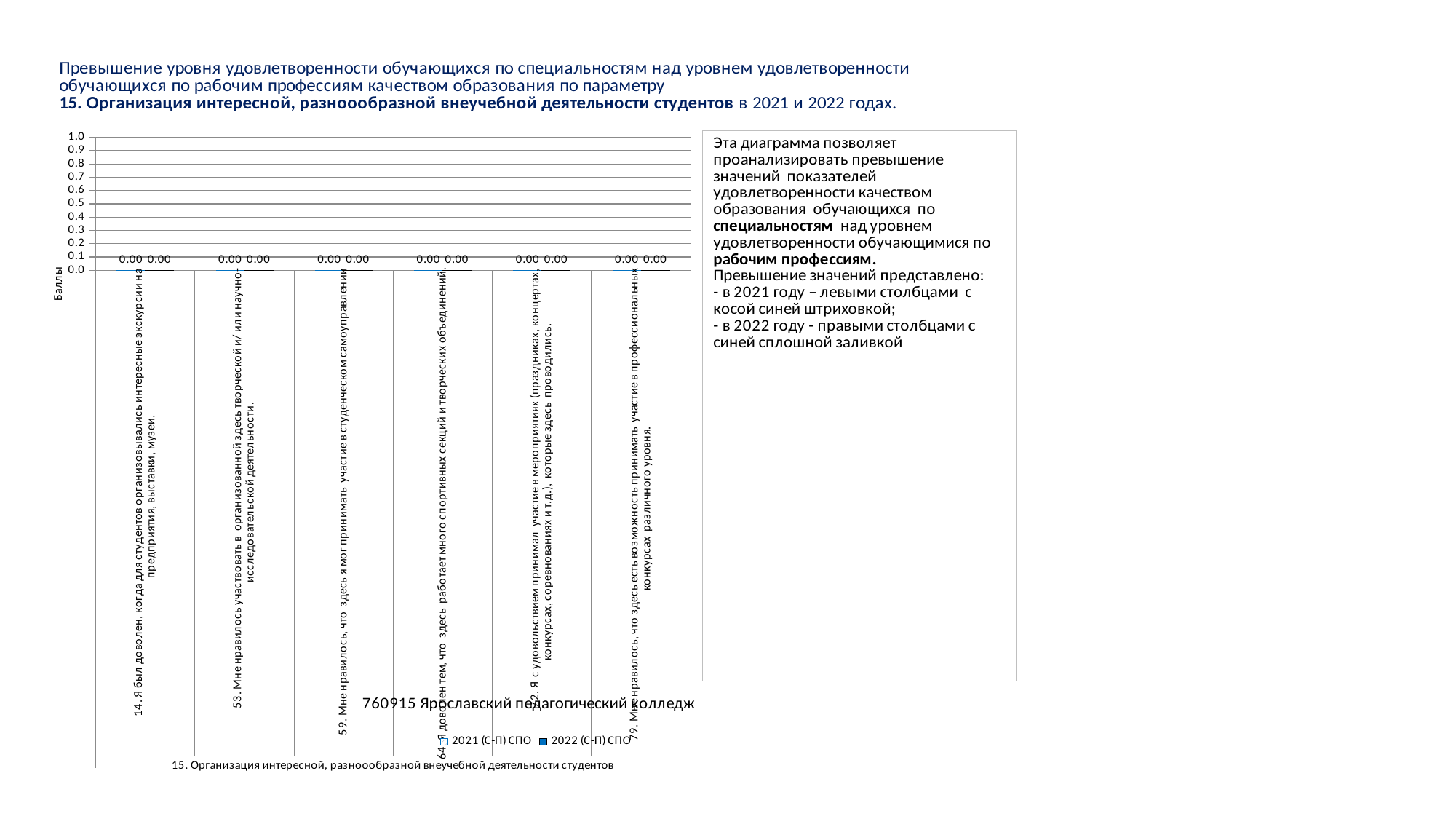
Is the value for 2021 (С-П) СПО for category 64 greater or less than 0.5? less How many categories are shown on the x axis of the chart? 6 What is the value for 2021 (С-П) СПО for category 14 (Я был доволен, когда для студентов организовывались интересные экскурсии на предприятия, выставки, музеи)? 0.00 What is the difference between the 2021 (С-П) СПО and 2022 (С-П) СПО values for category 72 (Я с удовольствием принимал участие в мероприятиях)? 0.00 What is the value for 2022 (С-П) СПО for category 53 (Мне нравилось участвовать в организованной здесь творческой и/или научно-исследовательской деятельности)? 0.00 What are the two series names listed in the chart legend? 2021 (С-П) СПО and 2022 (С-П) СПО What is the value for 2021 (С-П) СПО for category 59 (Мне нравилось, что здесь я мог принимать участие в студенческом самоуправлении)? 0.00 What is the label of the vertical axis of the chart? Баллы What is the value for 2022 (С-П) СПО for category 79 (Мне нравилось, что здесь есть возможность принимать участие в профессиональных конкурсах различного уровня)? 0.00 What kind of chart is shown on the slide? Bar chart How many series does the chart legend list? 2